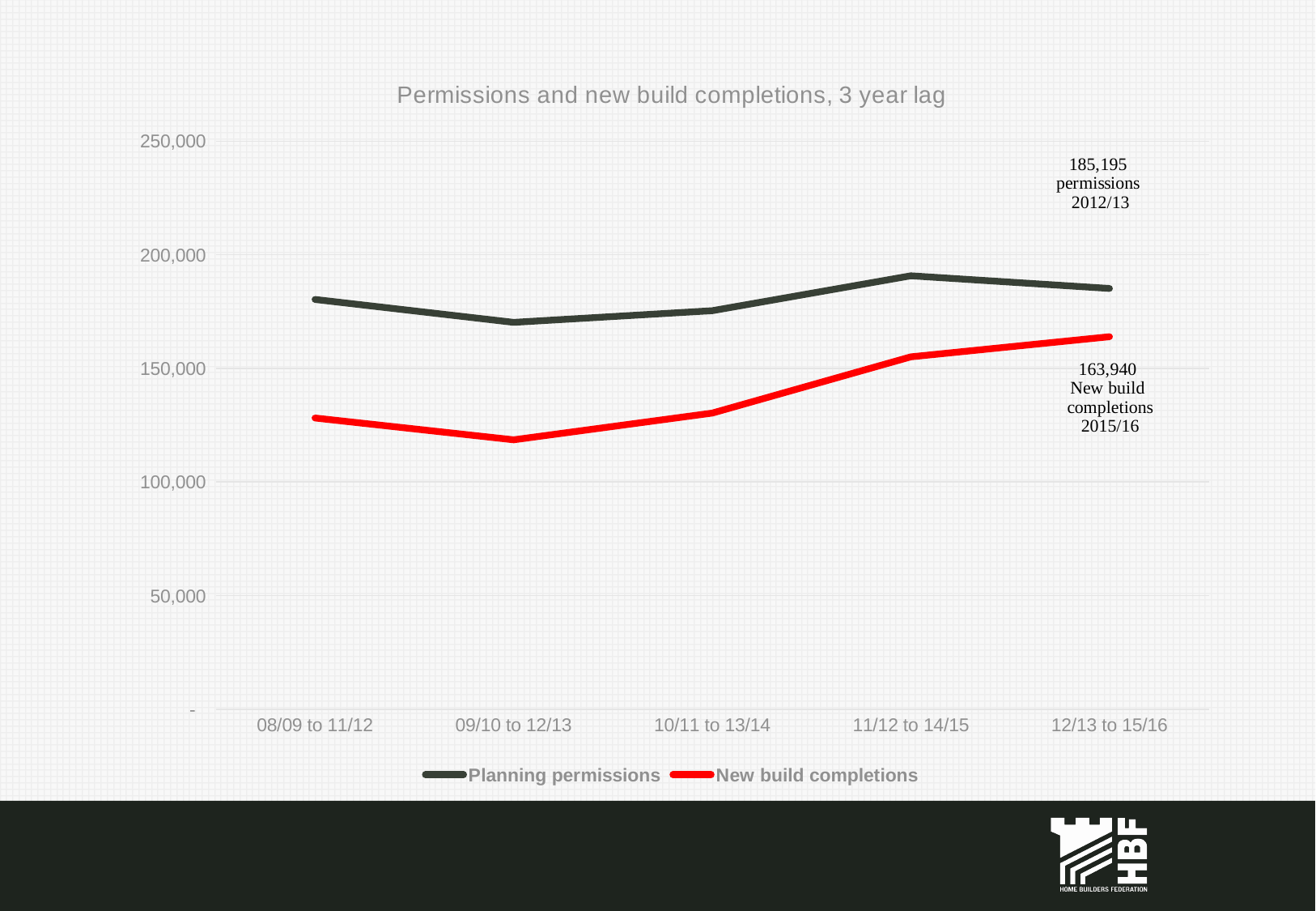
What is the value of Planning permissions for 12/13 to 15/16? 185,195 How many series does the legend list? 2 For 12/13 to 15/16, which series has the larger value, Planning permissions or New build completions? Planning permissions How many periods are shown along the x axis? 5 Is the value for New build completions in 08/09 to 11/12 greater or less than 150,000? less Do New build completions rise or fall from 09/10 to 12/13 through to 12/13 to 15/16? rise What kind of chart is shown on the slide? line chart What is the difference between Planning permissions and New build completions for 12/13 to 15/16? 21,255 In which period is New build completions at its lowest? 09/10 to 12/13 What is the value of New build completions for 12/13 to 15/16? 163,940 In which period is Planning permissions at its highest? 11/12 to 14/15 Is the value for Planning permissions in 09/10 to 12/13 greater or less than 150,000? greater